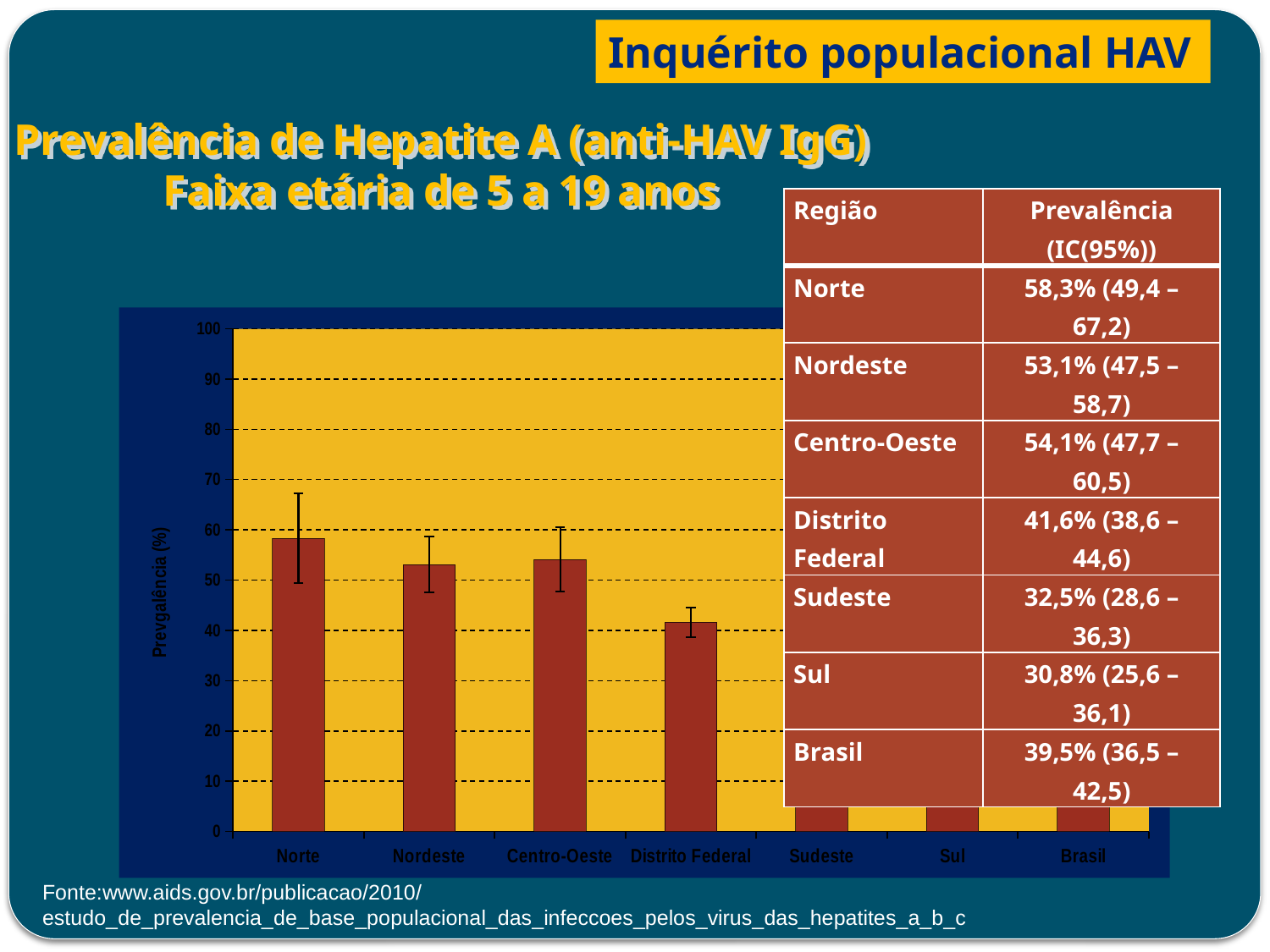
What type of chart is shown on the slide? bar chart Is the value for Distrito Federal greater or less than 50? less Which region has the highest prevalence? Norte What is the prevalence value for Sudeste? 32,5% What is the difference between the prevalence for Norte and for Distrito Federal? 16,7 percentage points What is the label of the y axis of the chart? Prevgalência (%) Which has a higher prevalence, Norte or Distrito Federal? Norte What is the prevalence value for Norte? 58,3% Is the value for Centro-Oeste greater or less than 50? greater What is the prevalence value for Brasil? 39,5% What is the prevalence value for Distrito Federal? 41,6% How many regions (categories) are plotted on the x axis of the chart? 7